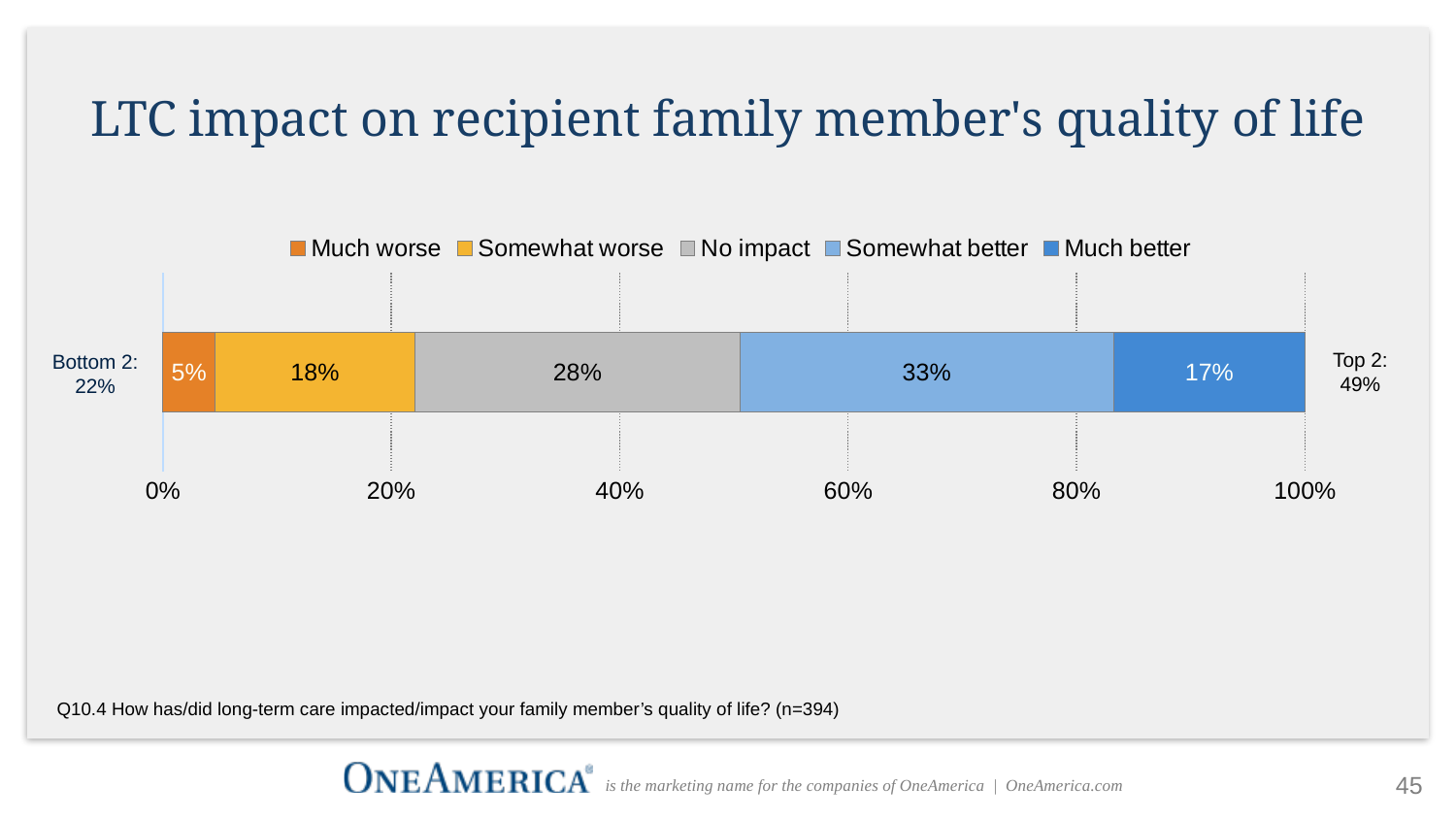
What percentage of respondents said long-term care made their family member's quality of life somewhat better? 33% What percentage of respondents said long-term care made their family member's quality of life much worse? 5% What is the difference in percentage points between 'Somewhat better' and 'Somewhat worse'? 15 What percentage of respondents said long-term care made their family member's quality of life much better? 17% What is the combined 'Top 2' percentage shown on the slide? 49% What is the combined 'Bottom 2' percentage shown on the slide? 22% What kind of chart is shown on the slide? Stacked bar chart Which response category has the smallest share in the chart? Much worse Which response category has the largest share in the chart? Somewhat better Which is larger, the share for 'No impact' or the share for 'Much better'? No impact What percentage of respondents said long-term care had no impact on their family member's quality of life? 28% How many response categories does the legend list? 5